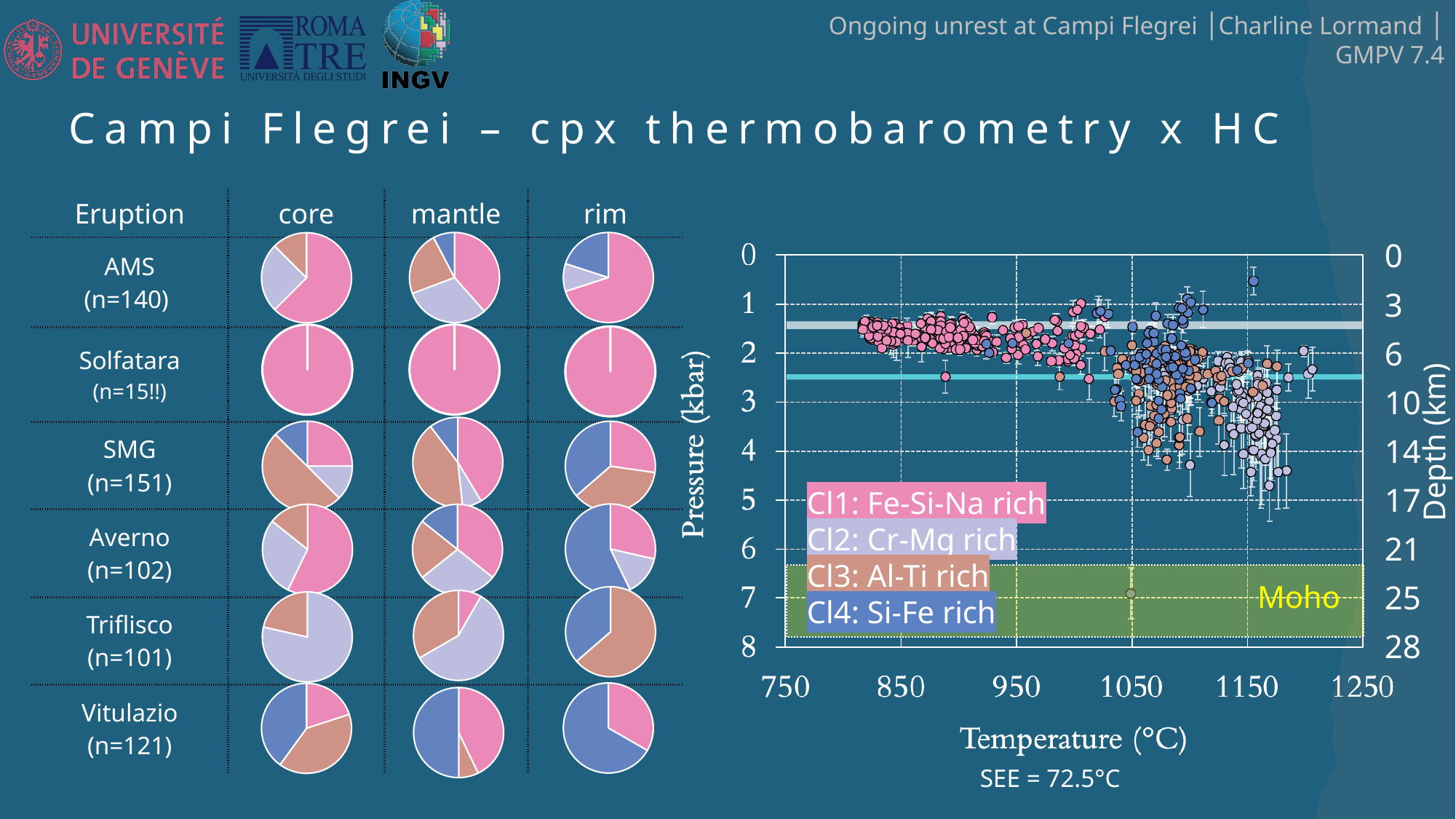
What is the label of the x axis of the scatter plot? Temperature (°C) In the scatter plot, which cluster sits at higher temperatures, Cl1 (Fe-Si-Na rich) or Cl2 (Cr-Mg rich)? Cl2 (Cr-Mg rich) What SEE value is printed below the scatter plot? 72.5°C In the pie chart table, what is the n value for SMG? 151 In the scatter plot, are the Cl1 (Fe-Si-Na rich) points mostly at temperatures greater or less than 1050°C? less In the pie chart table, what is the difference between the n for AMS and the n for Averno? 38 In the pie chart table, which eruption has the smallest n? Solfatara What does the green band near the bottom of the scatter plot represent? Moho What kind of chart is shown on the right side of the slide? scatter plot How many eruptions are listed in the pie chart table on the left? 6 In the pie chart table, which eruption has the largest n? SMG How many clusters does the legend of the scatter plot list? 4